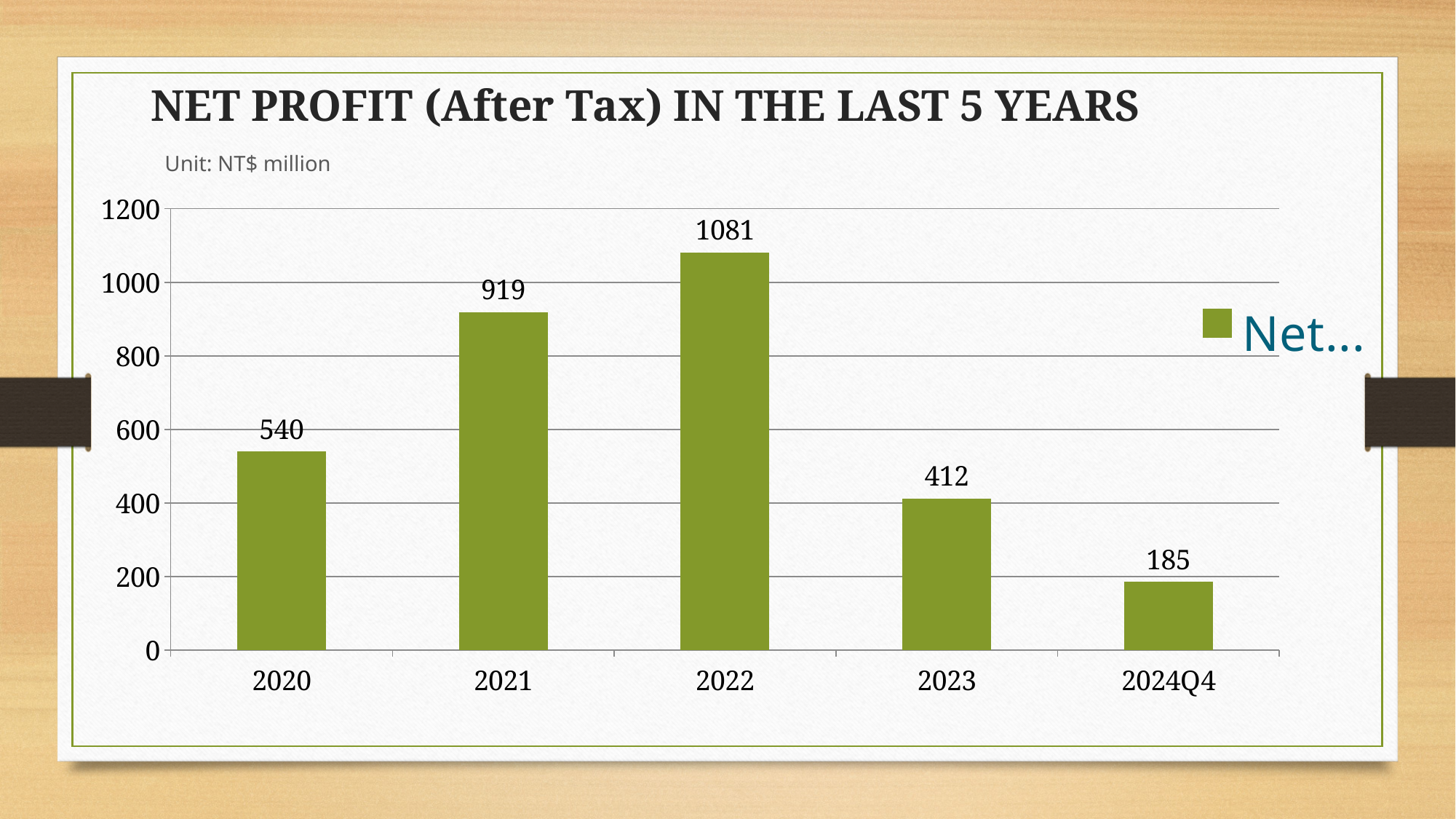
What is the difference between the net profit in 2022 and in 2021? 162 Is the value for 2021 greater or less than 800? greater What unit is stated for the values in the chart? NT$ million How many categories are shown on the x axis? 5 What kind of chart is shown on the slide? bar chart What is the difference between the net profit in 2023 and in 2024Q4? 227 Which is larger, the net profit for 2020 or for 2023? 2020 What is the net profit value for 2020? 540 What is the net profit value for 2022? 1081 Which year has the highest net profit? 2022 Which category has the lowest net profit? 2024Q4 What is the net profit value for 2024Q4? 185